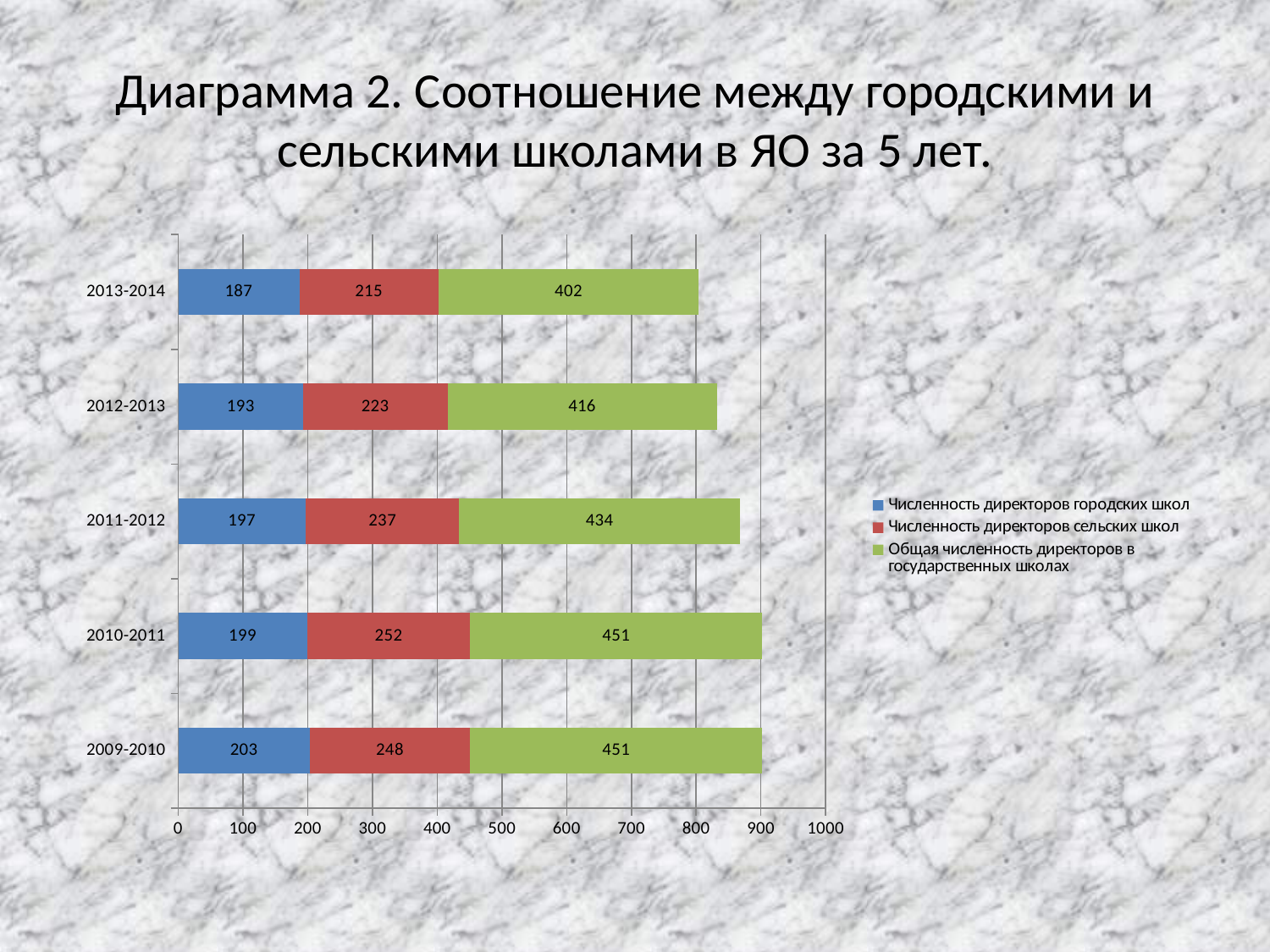
Which is larger: the total number of directors in state schools in 2011-2012 or in 2012-2013? 2011-2012 In which school year is the number of urban school directors the highest? 2009-2010 How many school years are shown on the chart? 5 What kind of chart is shown on the slide? Stacked bar chart How many series does the legend list? 3 In which school year is the number of rural school directors the lowest? 2013-2014 What is the number of rural school directors (Численность директоров сельских школ) for 2011-2012? 237 What is the total number of directors in state schools (Общая численность директоров в государственных школах) for 2012-2013? 416 What is the total of the stacked bar for 2013-2014? 804 What is the difference between the number of rural school directors in 2010-2011 and in 2009-2010? 4 What is the number of urban school directors (Численность директоров городских школ) for 2013-2014? 187 Going from 2009-2010 to 2013-2014, does the number of urban school directors rise or fall? Fall